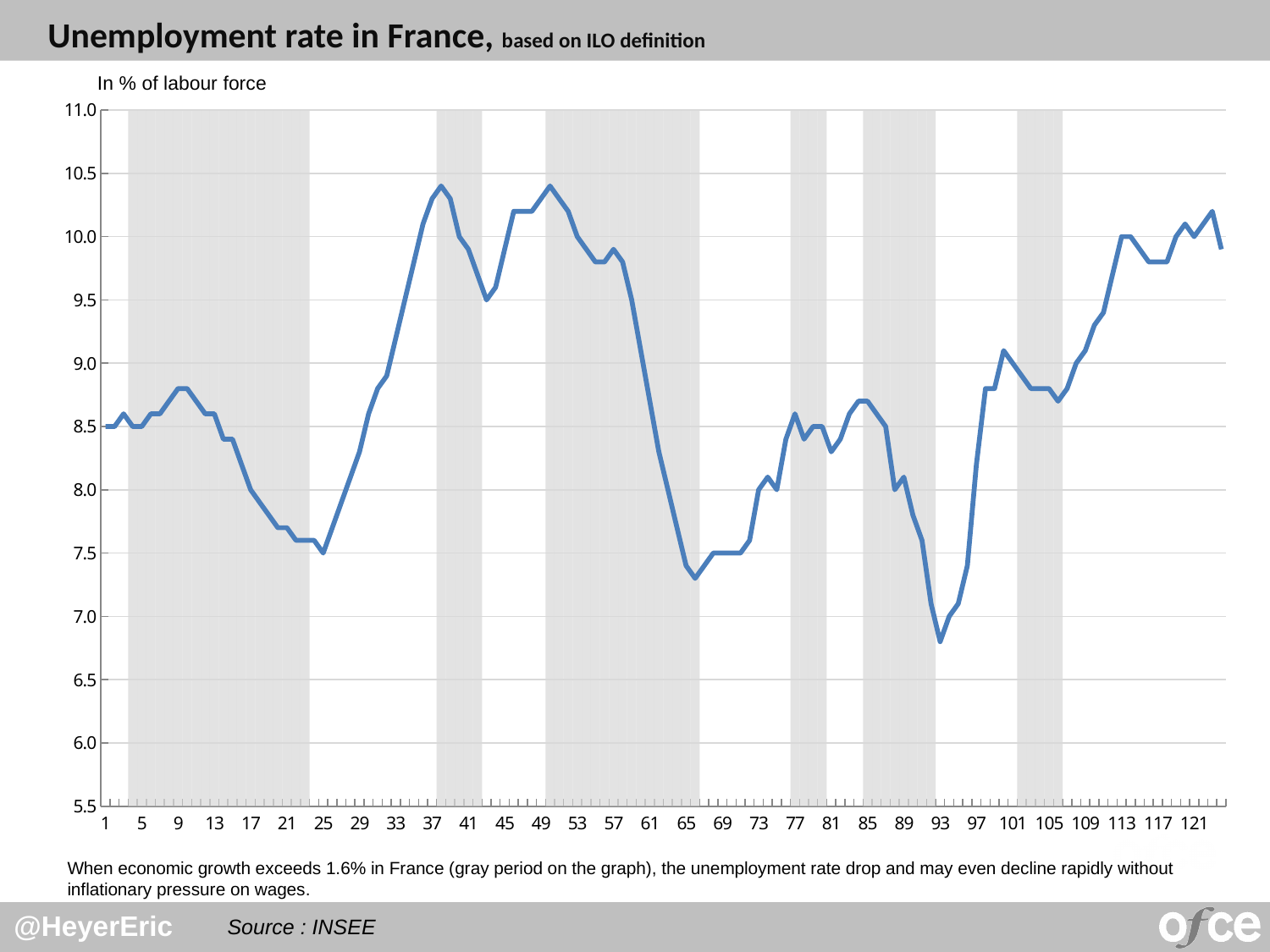
Around which x-axis point does the unemployment rate reach its lowest value? 93 Is the unemployment rate at point 57 greater or less than 9.5? greater What is the title of the chart? Unemployment rate in France, based on ILO definition Does the unemployment rate rise or fall between point 93 and point 101? rise Is the unemployment rate at point 38 greater or less than 10.0? greater Is the unemployment rate at point 65 greater or less than 7.5? less What kind of chart is shown on the slide? line chart Which is larger, the unemployment rate at point 38 or at point 93? point 38 In what unit are the values on the y axis expressed, according to the axis label? In % of labour force Does the unemployment rate rise or fall between point 57 and point 65? fall